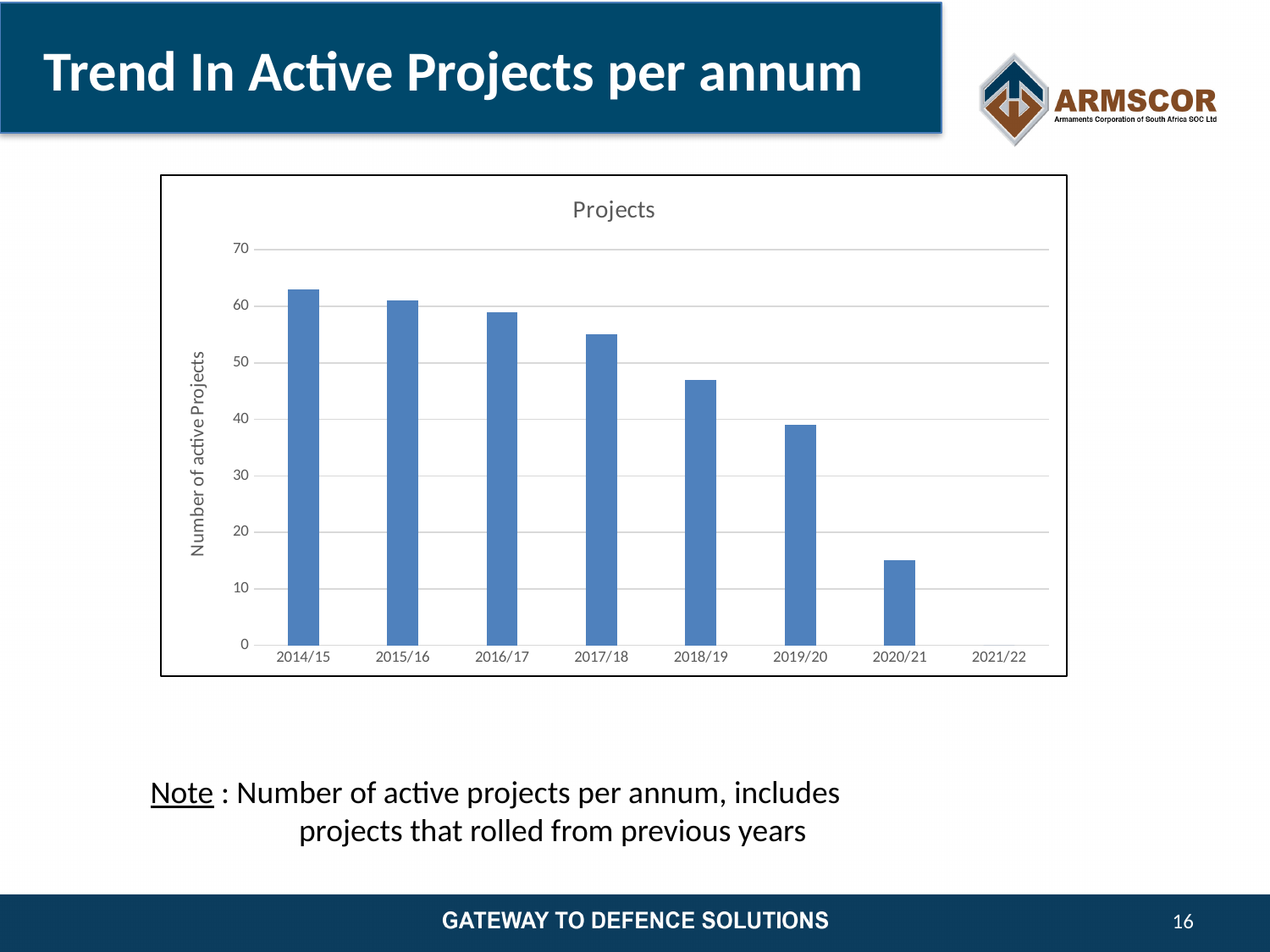
How many years are labelled on the x axis? 8 Is the value for 2020/21 greater or less than 20? less Which has more active projects, 2017/18 or 2018/19? 2017/18 What kind of chart is shown on the slide? Bar chart Is the value for 2019/20 greater or less than 30? greater Is the value for 2018/19 greater or less than 50? less Among the years with a visible bar, which has the lowest number of active projects? 2020/21 What is the label on the vertical axis of the chart? Number of active Projects Which year has the highest number of active projects? 2014/15 Do the values rise or fall from 2014/15 to 2020/21? Fall